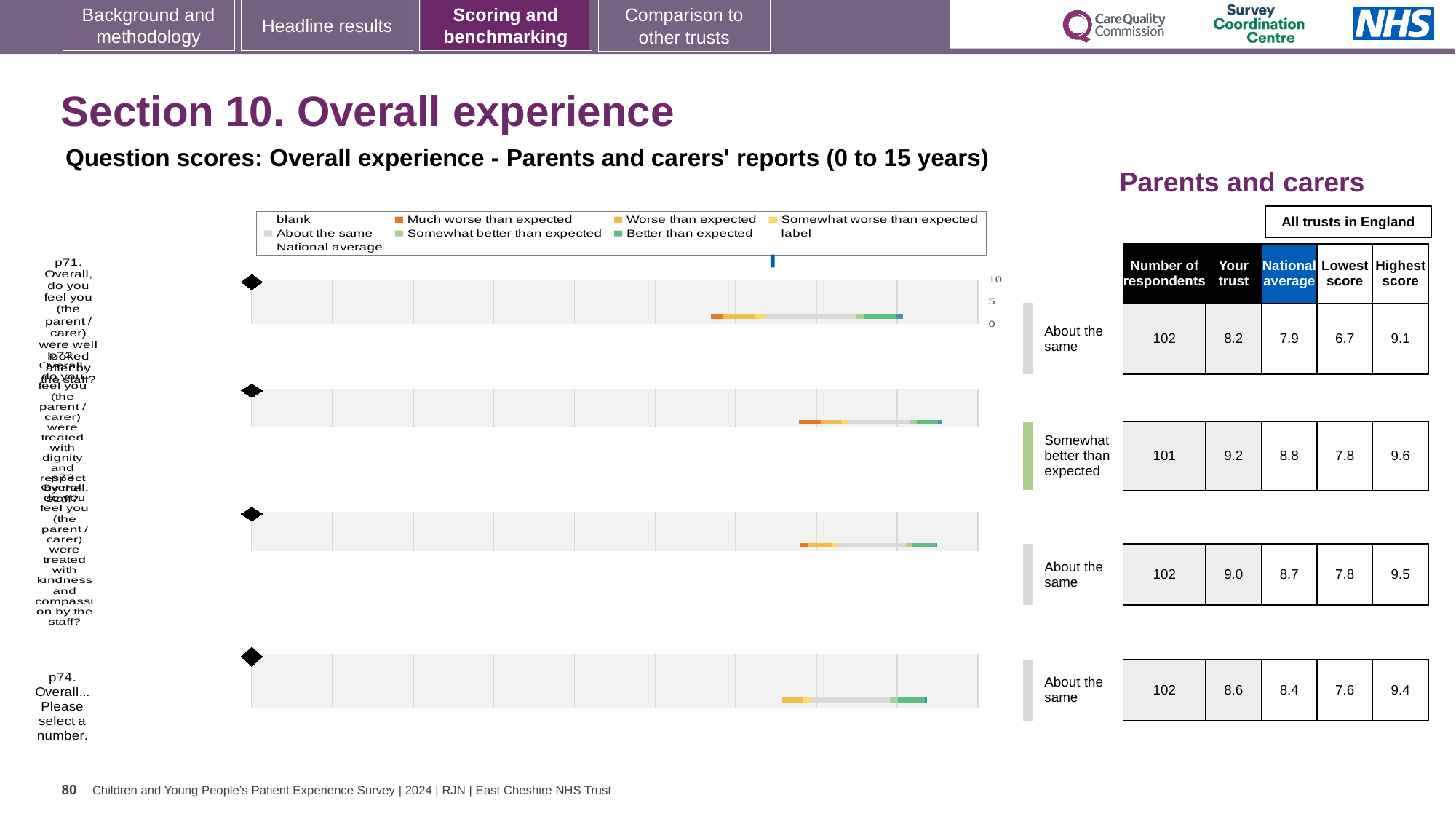
What is the 'Your trust' score for question p72 (treated with dignity and respect by the staff)? 9.2 What benchmark category is shown for question p72? Somewhat better than expected What is the highest score across all trusts in England for question p71 (well looked after by the staff)? 9.1 Which question has the lowest 'Your trust' score? p71 Which question has the highest 'Your trust' score? p72 What is the lowest score across all trusts in England for question p73 (treated with kindness and compassion)? 7.8 How many questions (rows) are plotted in the chart? 4 Which has the larger 'Your trust' score: question p73 or question p74? p73 What kind of chart is used to show the question scores? Bar chart What is the national average score for question p74 (Overall... Please select a number)? 8.4 How many respondents answered question p72? 101 What is the difference between the 'Your trust' score and the national average for question p71? 0.3